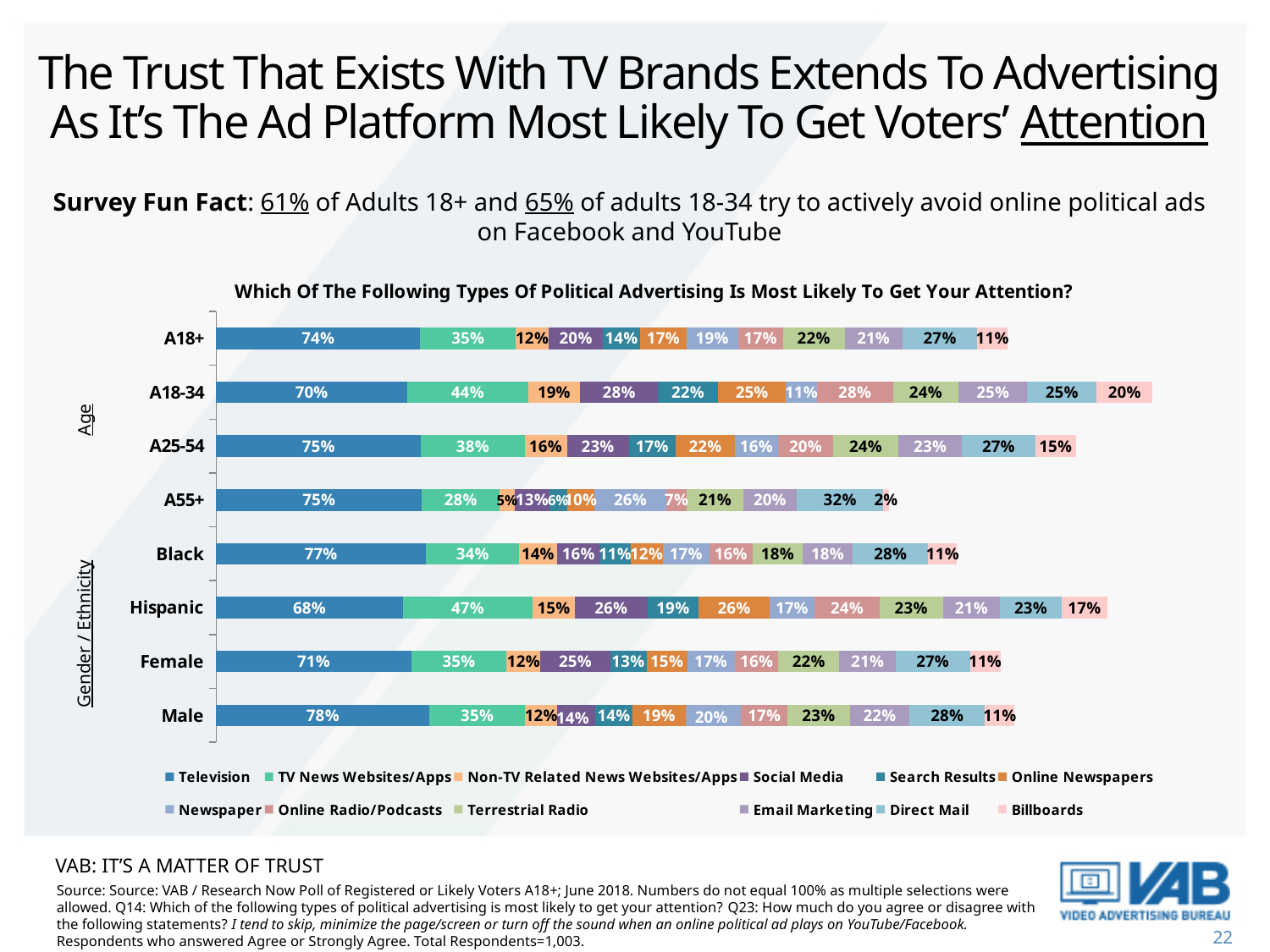
Which category has the highest Television value? Male What is the Television value for A18-34? 70% What is the Direct Mail value for A55+? 32% Which has the larger Television value, A18+ or A18-34? A18+ What is the difference between the TV News Websites/Apps values for A18-34 and A55+? 16 percentage points How many categories are shown on the y axis of the chart? 8 What kind of chart is shown on the slide? Stacked bar chart What is the TV News Websites/Apps value for Hispanic? 47% Which category has the lowest Television value? Hispanic How many series does the legend list? 12 What is the difference between the Television values for Male and Hispanic? 10 percentage points What is the Billboards value for A18-34? 20%